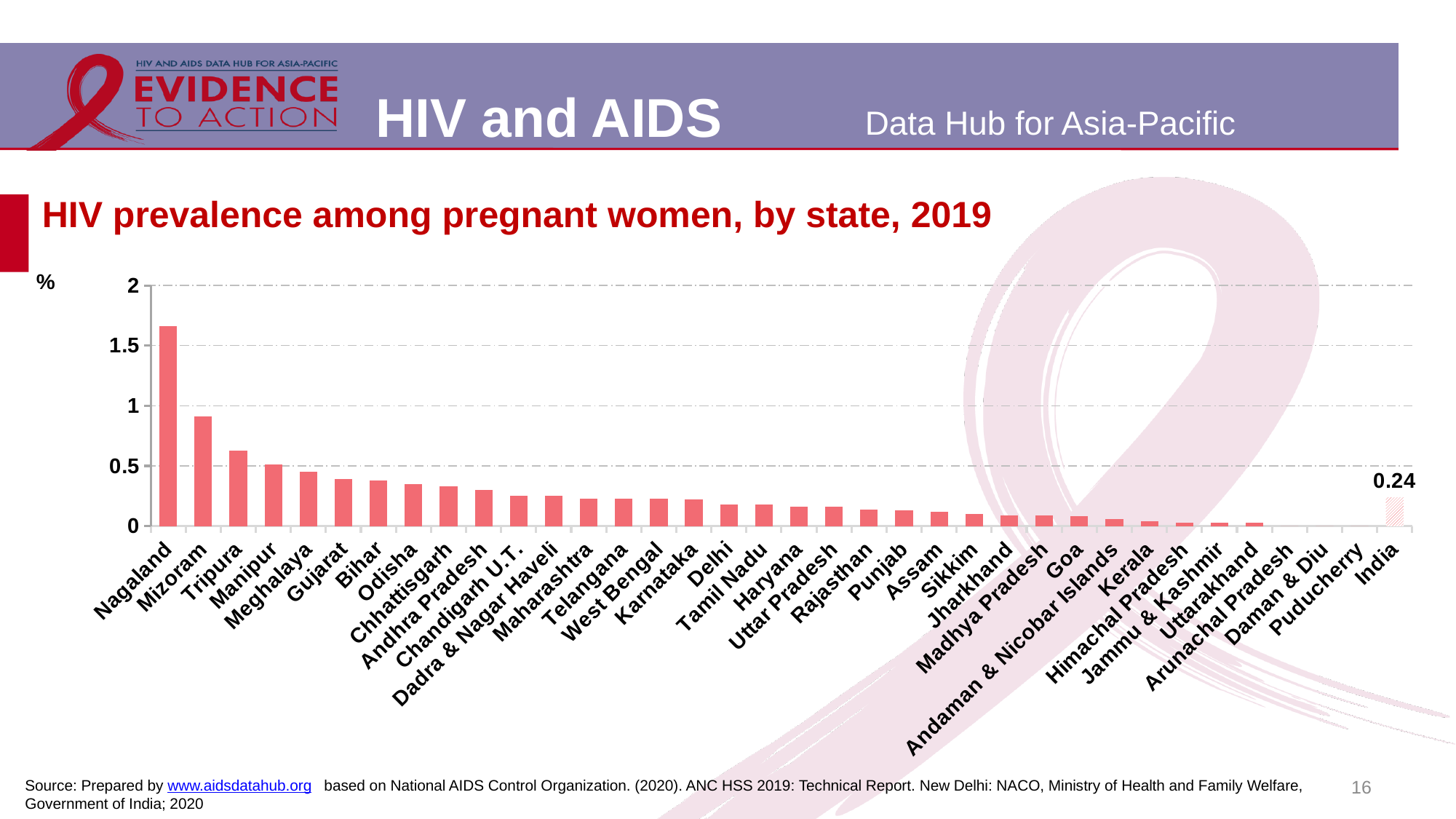
Which has a higher HIV prevalence among pregnant women, Nagaland or Mizoram? Nagaland Do the bar values generally rise or fall moving from left to right along the x axis? Fall Is the value for Tripura greater or less than 0.5? greater What is the title of the chart? HIV prevalence among pregnant women, by state, 2019 Which has a higher HIV prevalence among pregnant women, Tripura or Gujarat? Tripura Is the value for Mizoram greater or less than 1? less What kind of chart is shown on the slide? Bar chart Which state has the highest HIV prevalence among pregnant women in the chart? Nagaland Is the value for Nagaland greater or less than 1.5? greater What unit is shown on the y axis of the chart? % What is the HIV prevalence among pregnant women for India, as labelled on the chart? 0.24